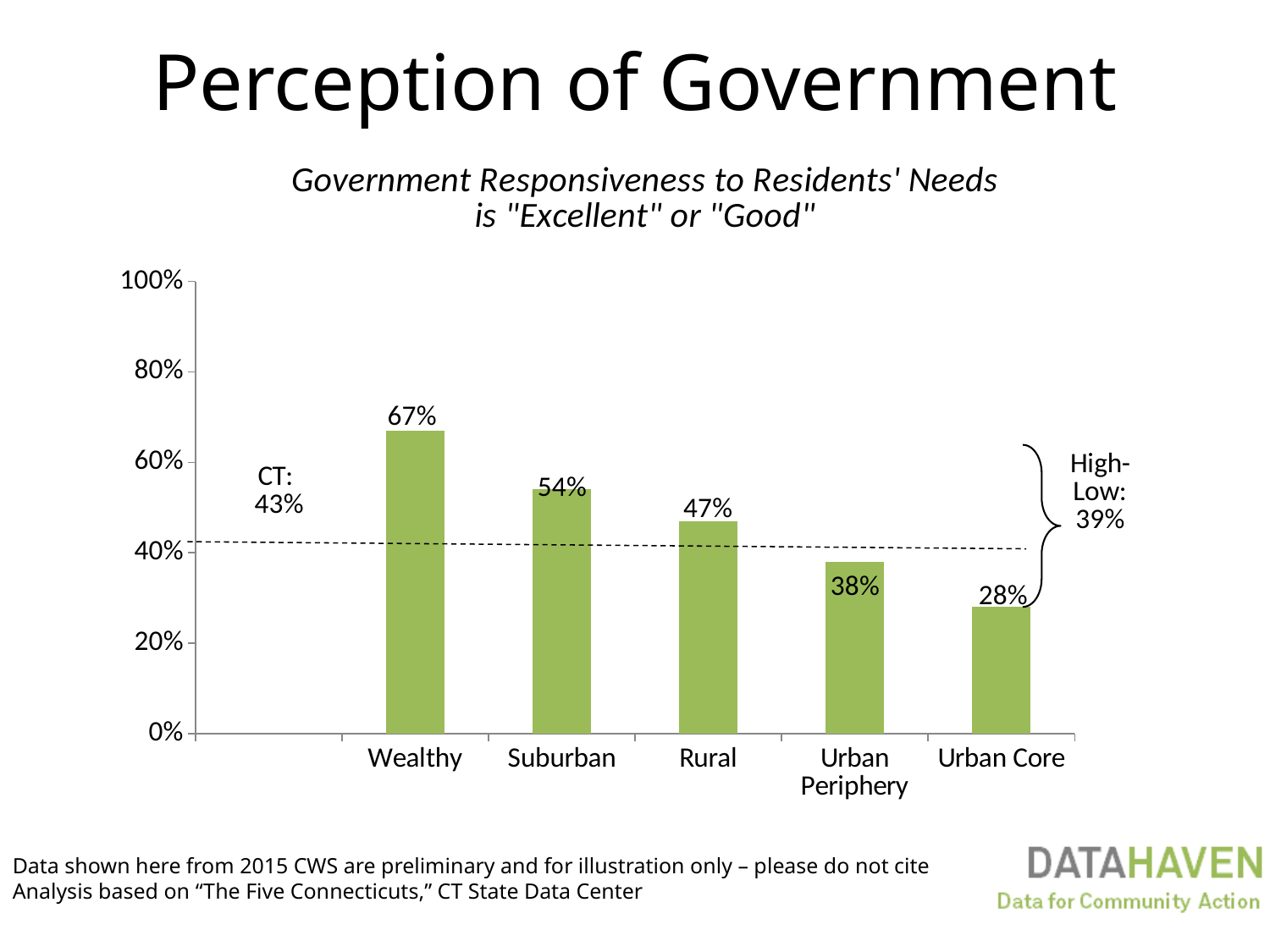
Which category has the highest value? Wealthy What is the difference between the Wealthy and Urban Core values? 39% Which category has the lowest value? Urban Core What is the value shown for Rural? 47% How many categories are shown on the x axis? 5 What percentage of Wealthy residents rate government responsiveness as "Excellent" or "Good"? 67% Which is larger, the value for Suburban or the value for Urban Periphery? Suburban What is the CT value indicated by the dashed line? 43% What is the value shown for Urban Periphery? 38% What kind of chart is shown on the slide? Bar chart What is the difference between the Suburban and Rural values? 7% Do the values rise or fall moving from Wealthy to Urban Core along the x axis? Fall